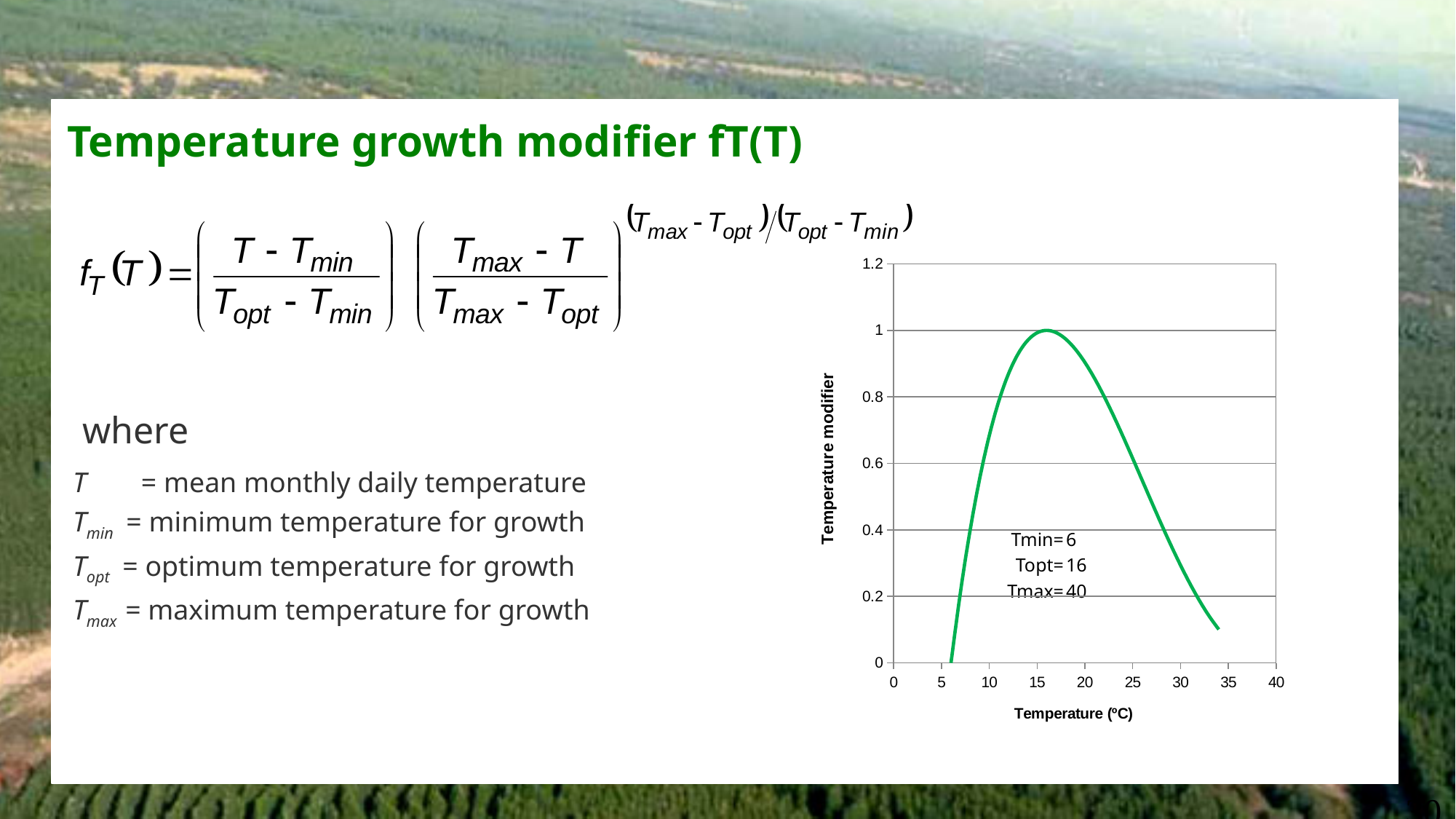
According to the annotation on the chart, what is the value of Tmin? 6 According to the annotation on the chart, what is the value of Topt? 16 What is the label of the y axis of the chart? Temperature modifier What is the label of the x axis of the chart? Temperature (ºC) What is the maximum value the temperature modifier reaches on the chart? 1 Is the temperature modifier at 20 ºC greater or less than 0.8? greater According to the annotation on the chart, what is the value of Tmax? 40 Which has the larger temperature modifier, 10 ºC or 30 ºC? 10 ºC Is the temperature modifier at 30 ºC greater or less than 0.4? less Does the temperature modifier rise or fall as temperature increases from 20 ºC to 34 ºC? fall What kind of chart is shown on the slide? line chart At what temperature does the curve reach its peak value of 1? 16